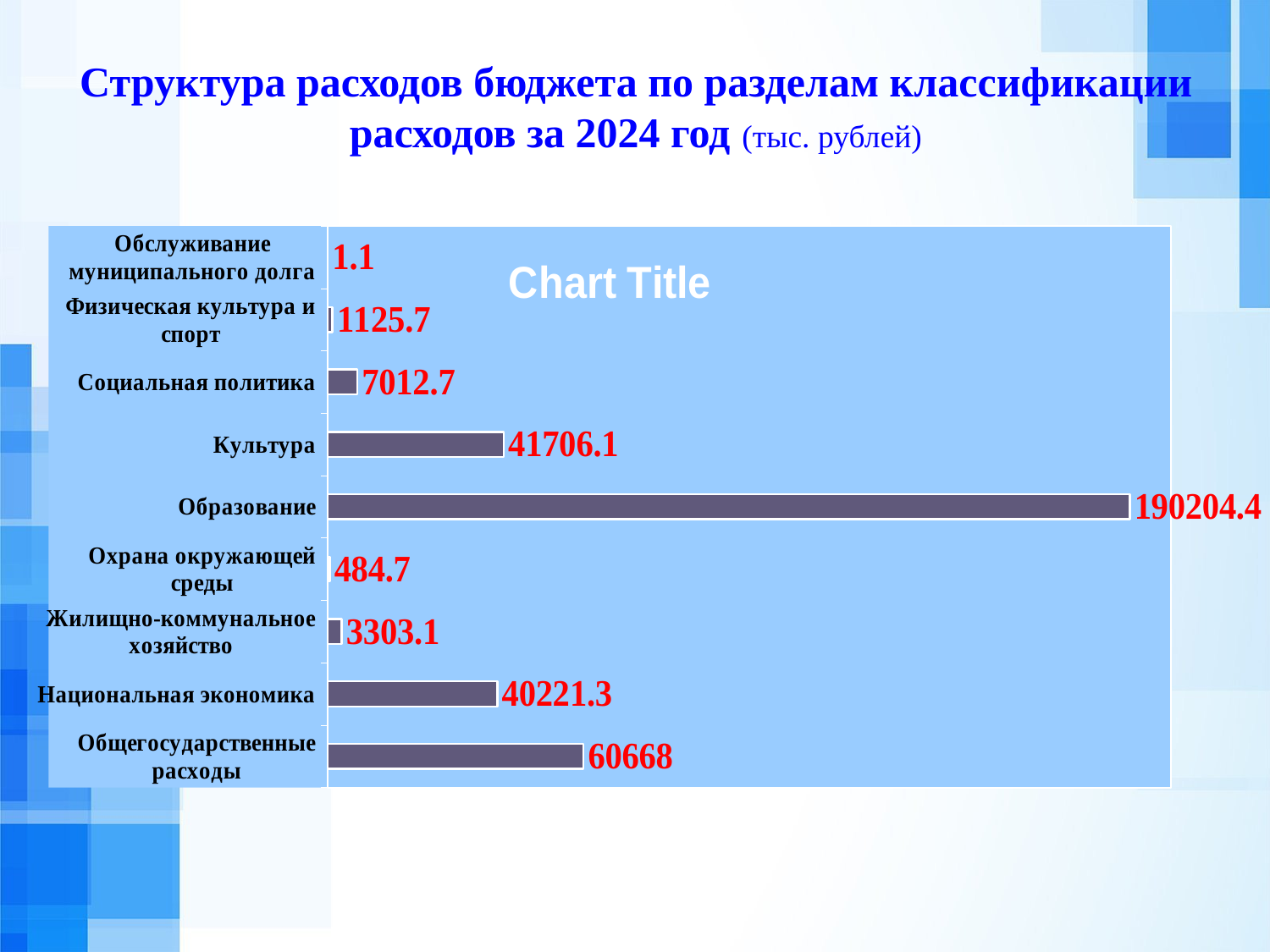
Which category has the highest value? Образование Which is larger, the value for Социальная политика or the value for Жилищно-коммунальное хозяйство? Социальная политика What is the difference between the values for Культура and Национальная экономика? 1484.8 What is the value for Образование? 190204.4 What is the value for Обслуживание муниципального долга? 1.1 What kind of chart is shown on the slide? Bar chart How many categories are shown in the chart? 9 What is the difference between the values for Общегосударственные расходы and Культура? 18961.9 What is the value for Культура? 41706.1 What is the value for Общегосударственные расходы? 60668 What title text is displayed inside the chart area? Chart Title Which category has the lowest value? Обслуживание муниципального долга